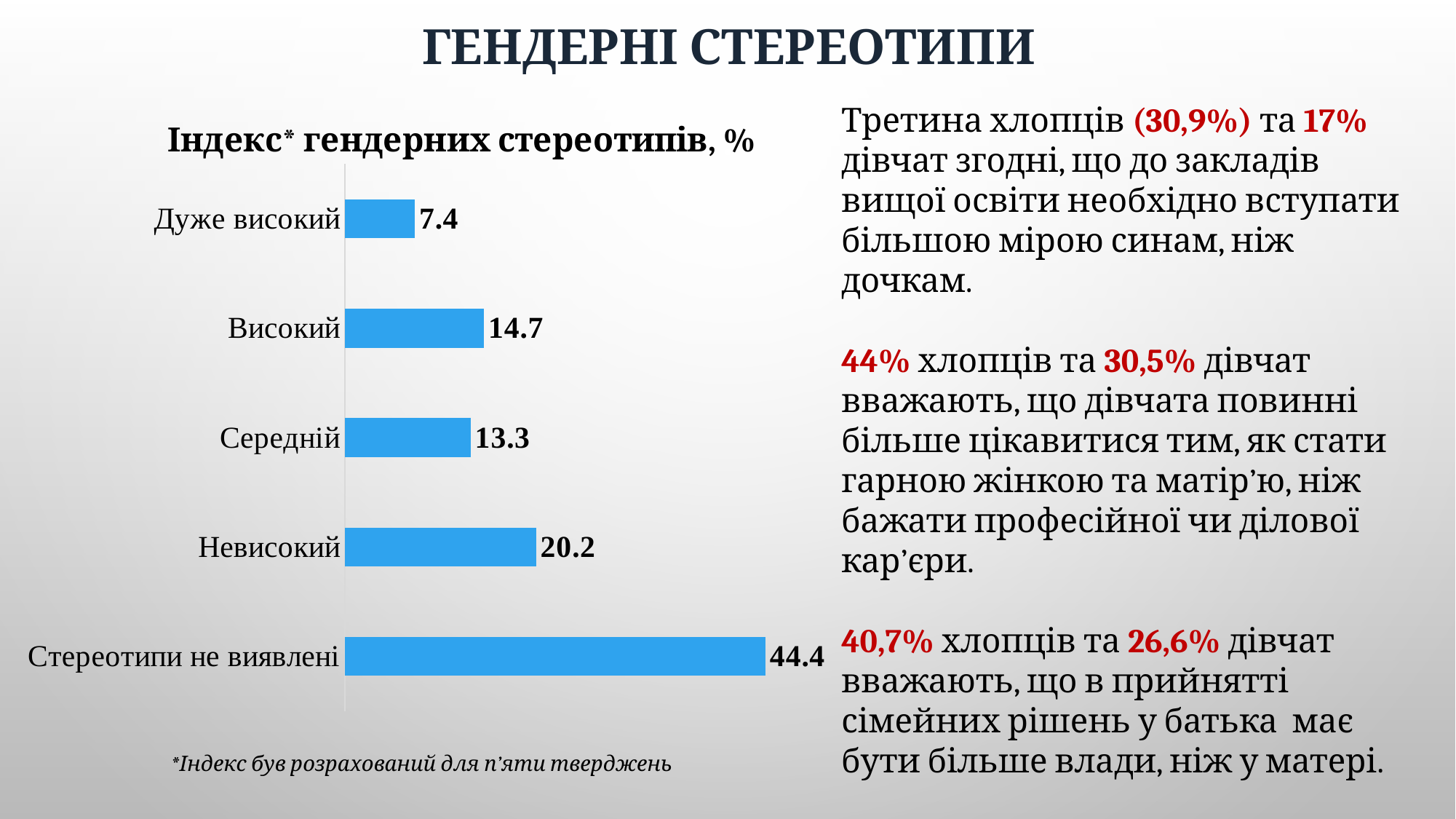
What is the value for "Невисокий"? 20.2 What kind of chart is shown on the slide? Bar chart Which is larger, the value for "Високий" or the value for "Середній"? Високий What is the value for "Стереотипи не виявлені"? 44.4 How many categories are shown in the chart? 5 Which category has the highest value? Стереотипи не виявлені What is the difference between the values for "Невисокий" and "Високий"? 5.5 What is the value for "Високий"? 14.7 Which category has the lowest value? Дуже високий What is the value for "Дуже високий"? 7.4 What is the title of the chart? Індекс* гендерних стереотипів, % What is the value for "Середній"? 13.3